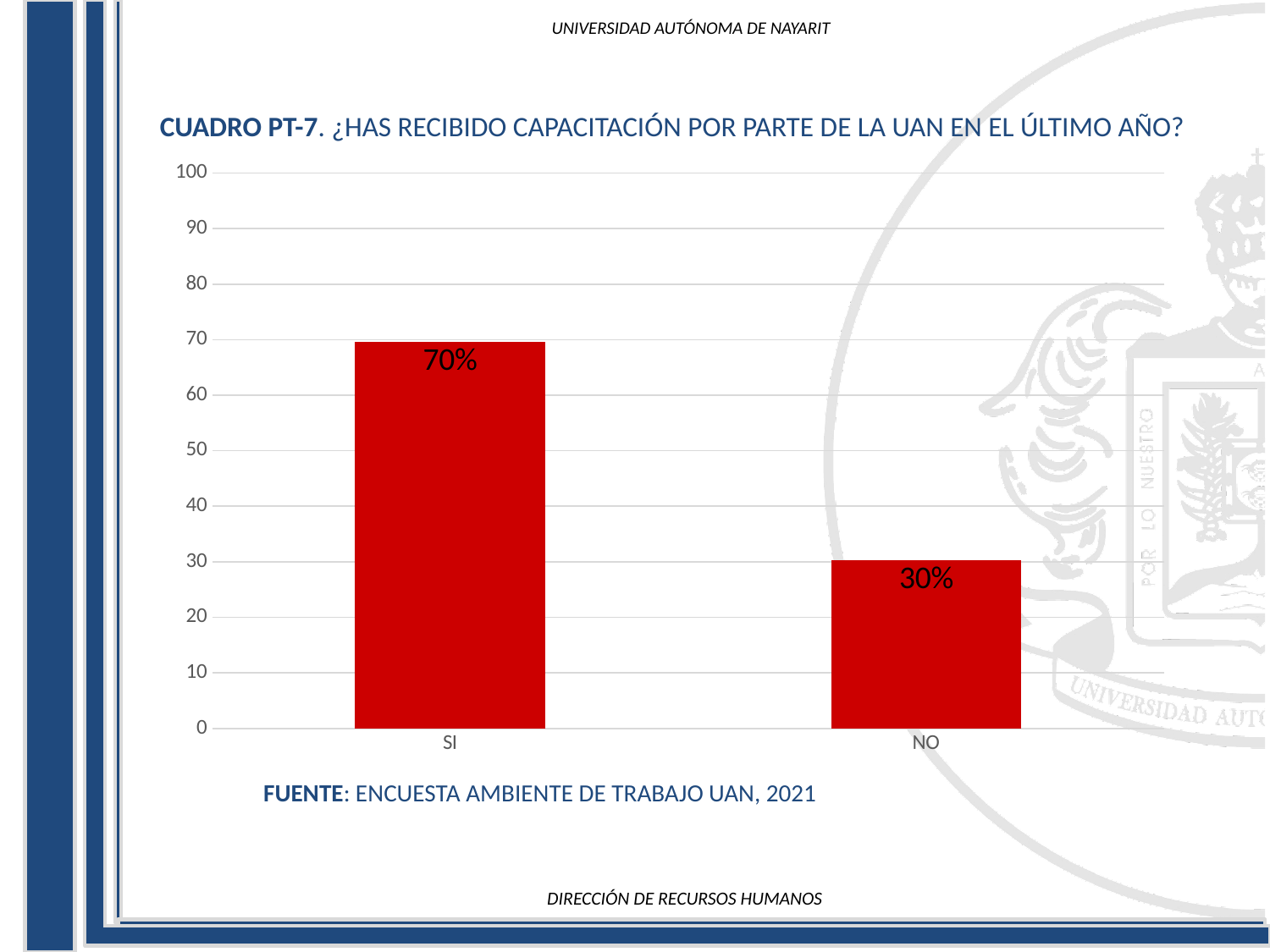
What is the title of the chart? CUADRO PT-7. ¿HAS RECIBIDO CAPACITACIÓN POR PARTE DE LA UAN EN EL ÚLTIMO AÑO? Is the value for NO greater or less than 40? less Is the value for SI greater or less than 60? greater Which is larger, the value for SI or the value for NO? SI How many categories are shown on the x axis? 2 What colour are the bars in the chart? red What is the value for SI? 70% What kind of chart is shown on the slide? bar chart What is the value for NO? 30% Which category has the highest value? SI Which category has the lowest value? NO What is the difference between the values for SI and NO? 40%